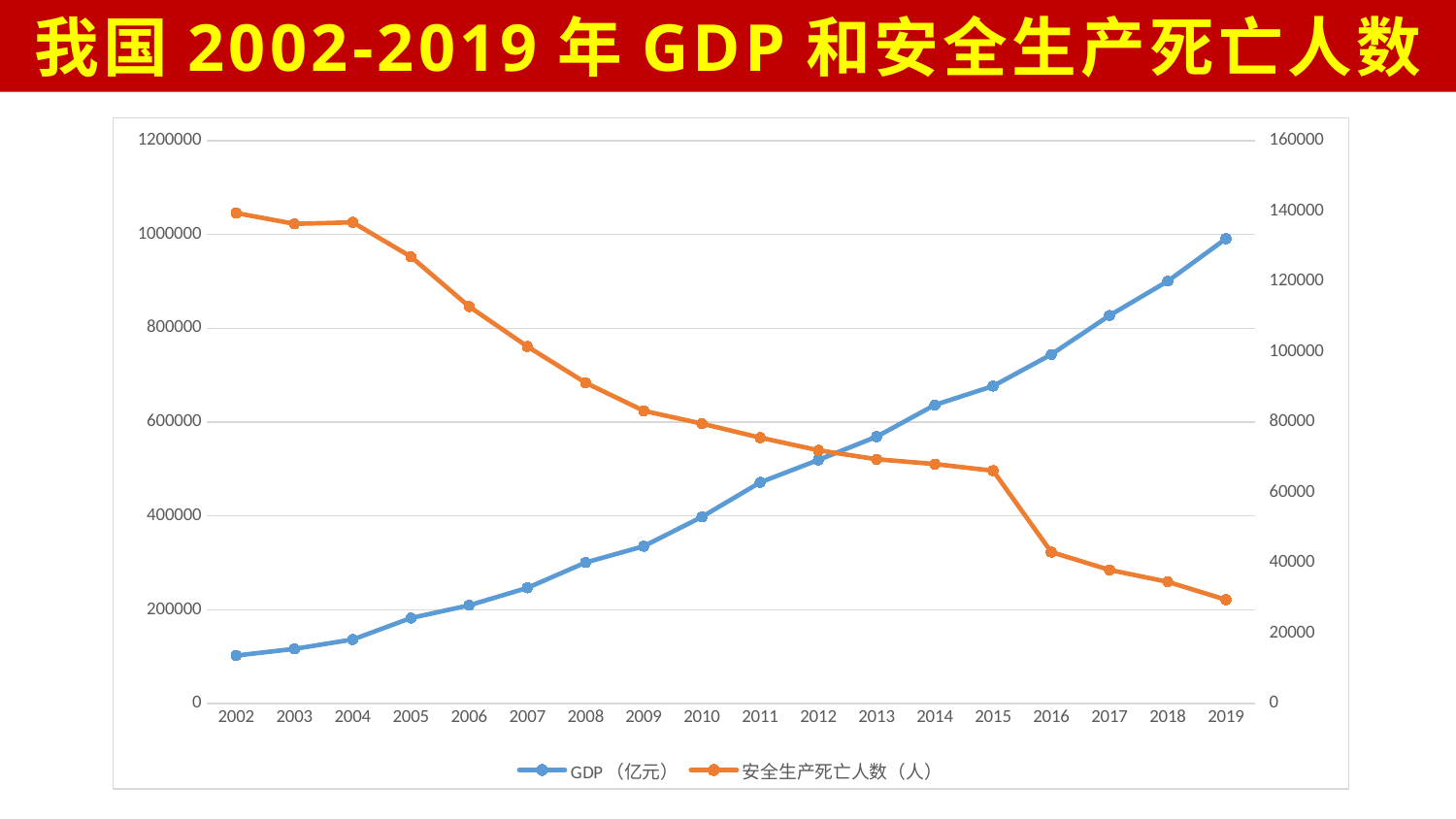
Does the GDP (亿元) series rise or fall from 2002 to 2019? rise Does the 安全生产死亡人数 (人) series rise or fall from 2002 to 2019? fall In which year is the 安全生产死亡人数 (人) series at its highest? 2002 In which year is the GDP (亿元) series at its highest? 2019 In which year is the GDP (亿元) series at its lowest? 2002 Is the GDP (亿元) value for 2019 greater or less than 800000 on the left axis? greater How many series does the legend list? 2 What kind of chart is shown on the slide? line chart Is the 安全生产死亡人数 (人) value for 2019 greater or less than 40000 on the right axis? less Which colour is used for the GDP (亿元) line? blue In which year is the 安全生产死亡人数 (人) series at its lowest? 2019 How many years are plotted along the x axis? 18